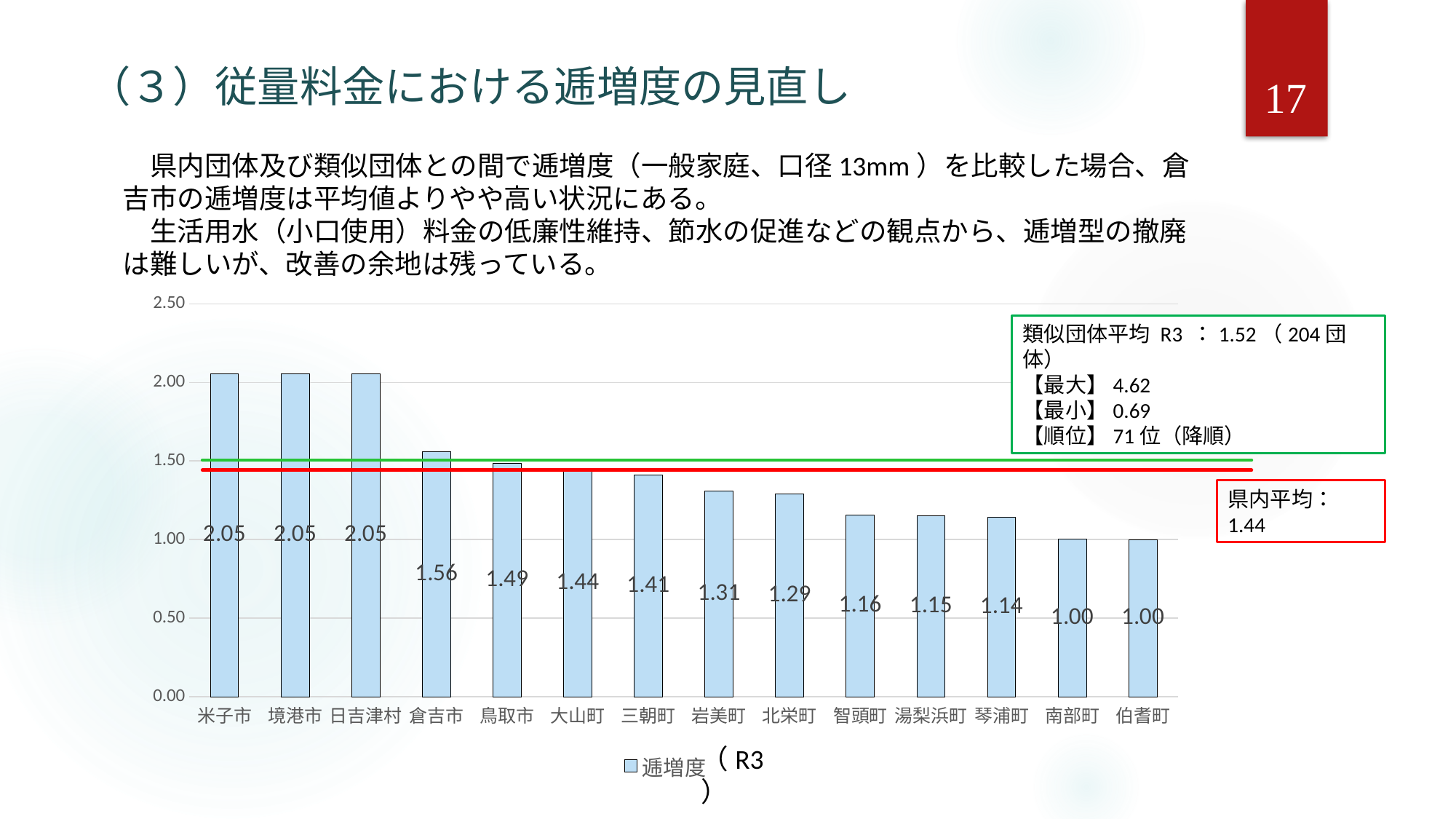
What is the value for 琴浦町? 1.14 Which has a larger value, 三朝町 or 北栄町? 三朝町 What is the lowest value shown by any bar in the chart? 1.00 What is the value for 倉吉市? 1.56 What is the difference between the values for 倉吉市 and 鳥取市? 0.07 What is the value for 鳥取市? 1.49 What value does the red line labelled 県内平均 represent? 1.44 How many categories (municipalities) are shown on the x axis? 14 What kind of chart is shown on the slide? bar chart What is the value for 岩美町? 1.31 What is the highest value shown by any bar in the chart? 2.05 Is the value for 米子市 greater or less than 2.00? greater